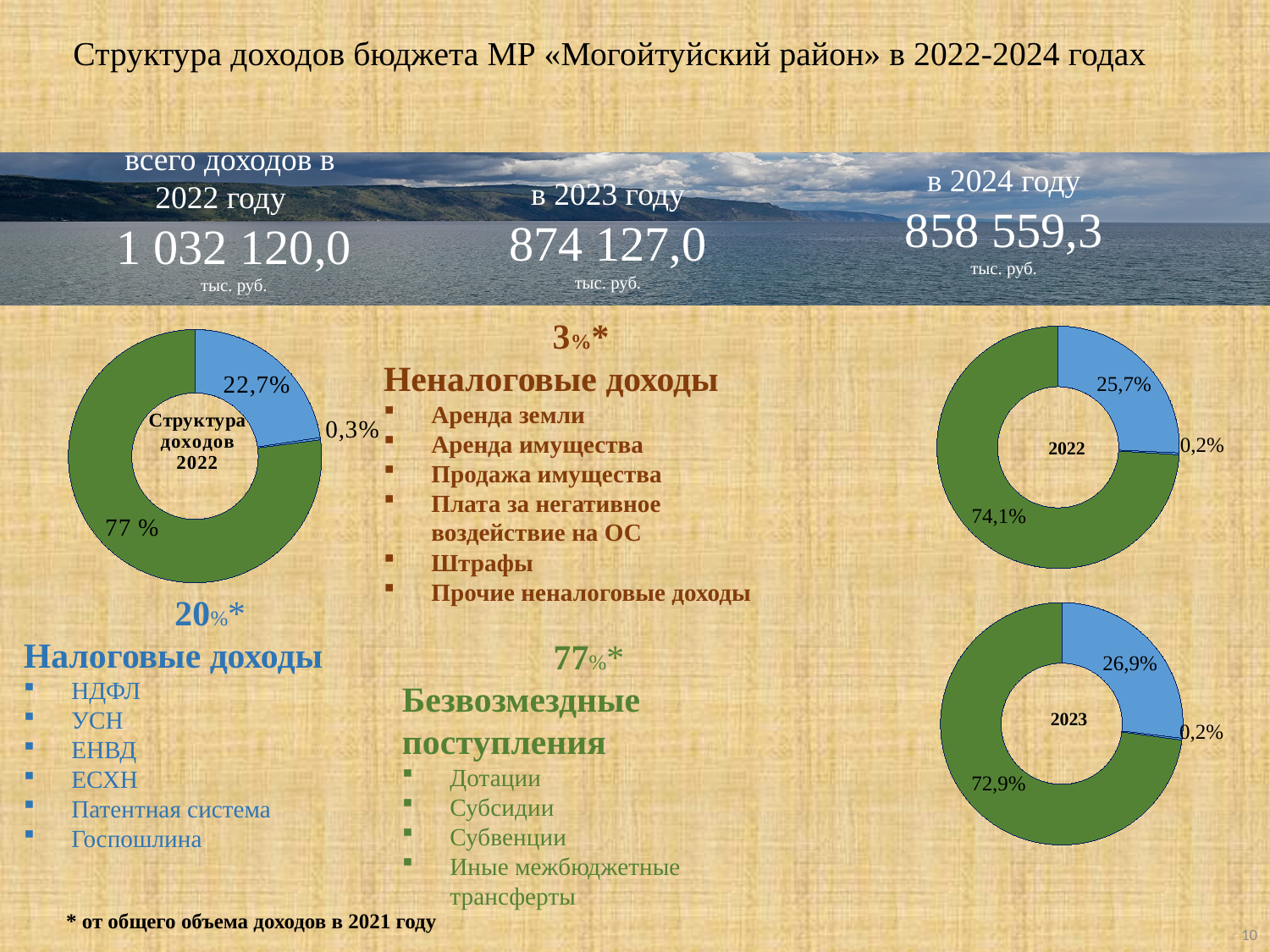
In the left chart labelled 'Структура доходов 2022', what is the difference between the green slice (77 %) and the blue slice (22,7%)? 54,3% In the top-right chart labelled '2022', what is the value of the blue slice? 25,7% What is the difference between the green slice of the top-right chart ('2022', 74,1%) and the green slice of the bottom-right chart ('2023', 72,9%)? 1,2% In the bottom-right chart labelled '2023', what is the value of the blue slice? 26,9% What kind of chart is used for the three charts on the slide? pie chart (doughnut) In the left chart labelled 'Структура доходов 2022', what is the value of the smallest slice? 0,3% In the bottom-right chart labelled '2023', what is the value of the largest slice? 72,9% In the left chart labelled 'Структура доходов 2022', what is the value of the largest slice? 77 % In the left chart labelled 'Структура доходов 2022', what is the value of the blue slice? 22,7% Comparing the blue slices of the top-right chart ('2022') and the bottom-right chart ('2023'), which chart has the larger blue share? 2023 How many pie charts are shown on the slide? 3 In the top-right chart labelled '2022', what is the value of the green slice? 74,1%